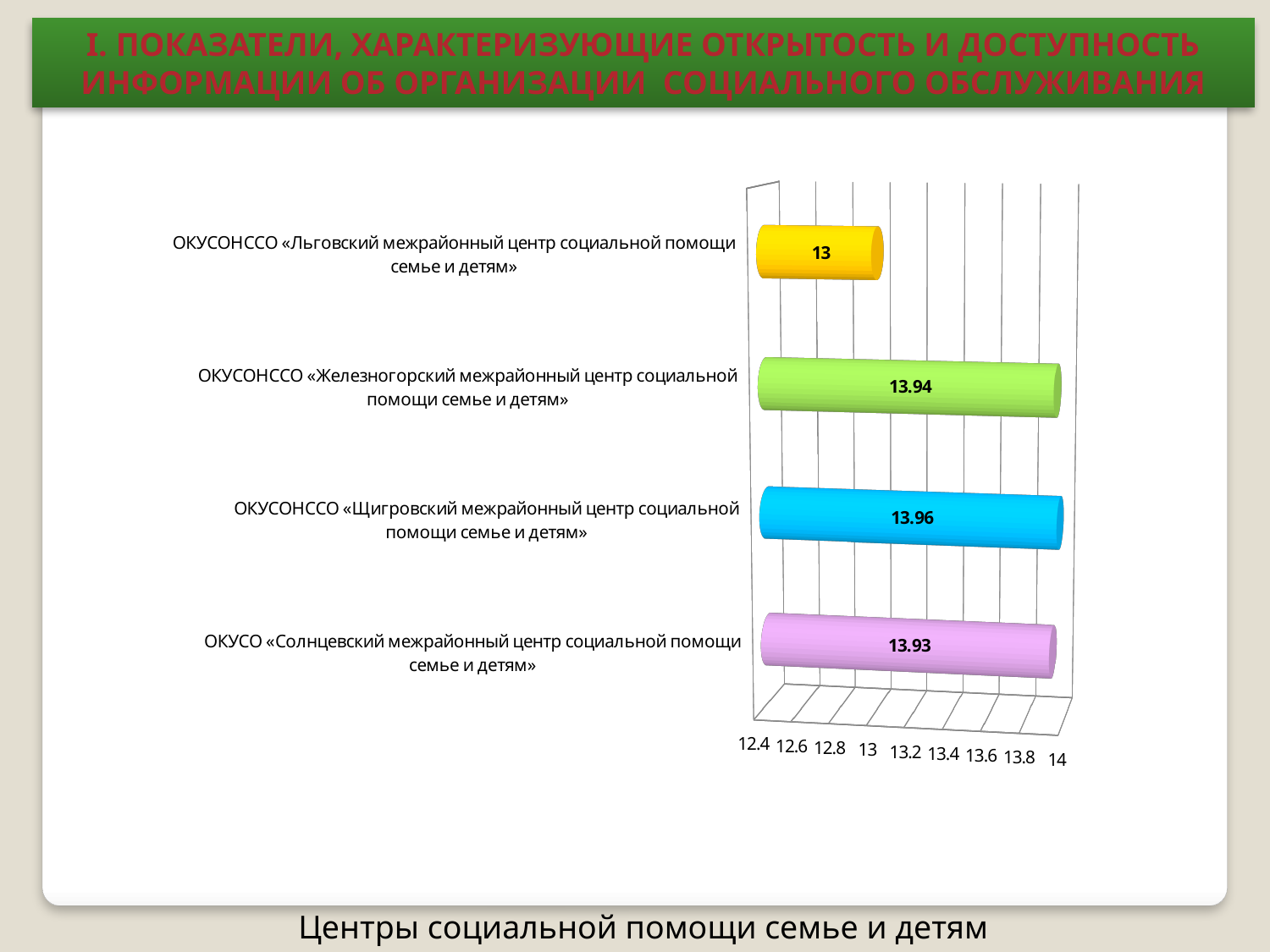
What is the value for ОКУСОНССО «Льговский межрайонный центр социальной помощи семье и детям»? 13 What is the value for ОКУСОНССО «Железногорский межрайонный центр социальной помощи семье и детям»? 13.94 What is the value for ОКУСО «Солнцевский межрайонный центр социальной помощи семье и детям»? 13.93 What is the difference between the values for the Железногорский centre and the Солнцевский centre? 0.01 Is the value for the Солнцевский centre greater or less than 13.8? greater How many organisations are shown on the chart? 4 What is the difference between the values for the Щигровский centre and the Льговский centre? 0.96 Which organisation has the lowest value on the chart? ОКУСОНССО «Льговский межрайонный центр социальной помощи семье и детям» What is the value for ОКУСОНССО «Щигровский межрайонный центр социальной помощи семье и детям»? 13.96 What kind of chart is shown on the slide? bar chart Which organisation has the highest value on the chart? ОКУСОНССО «Щигровский межрайонный центр социальной помощи семье и детям» Which has a larger value, the Железногорский centre or the Солнцевский centre? ОКУСОНССО «Железногорский межрайонный центр социальной помощи семье и детям»